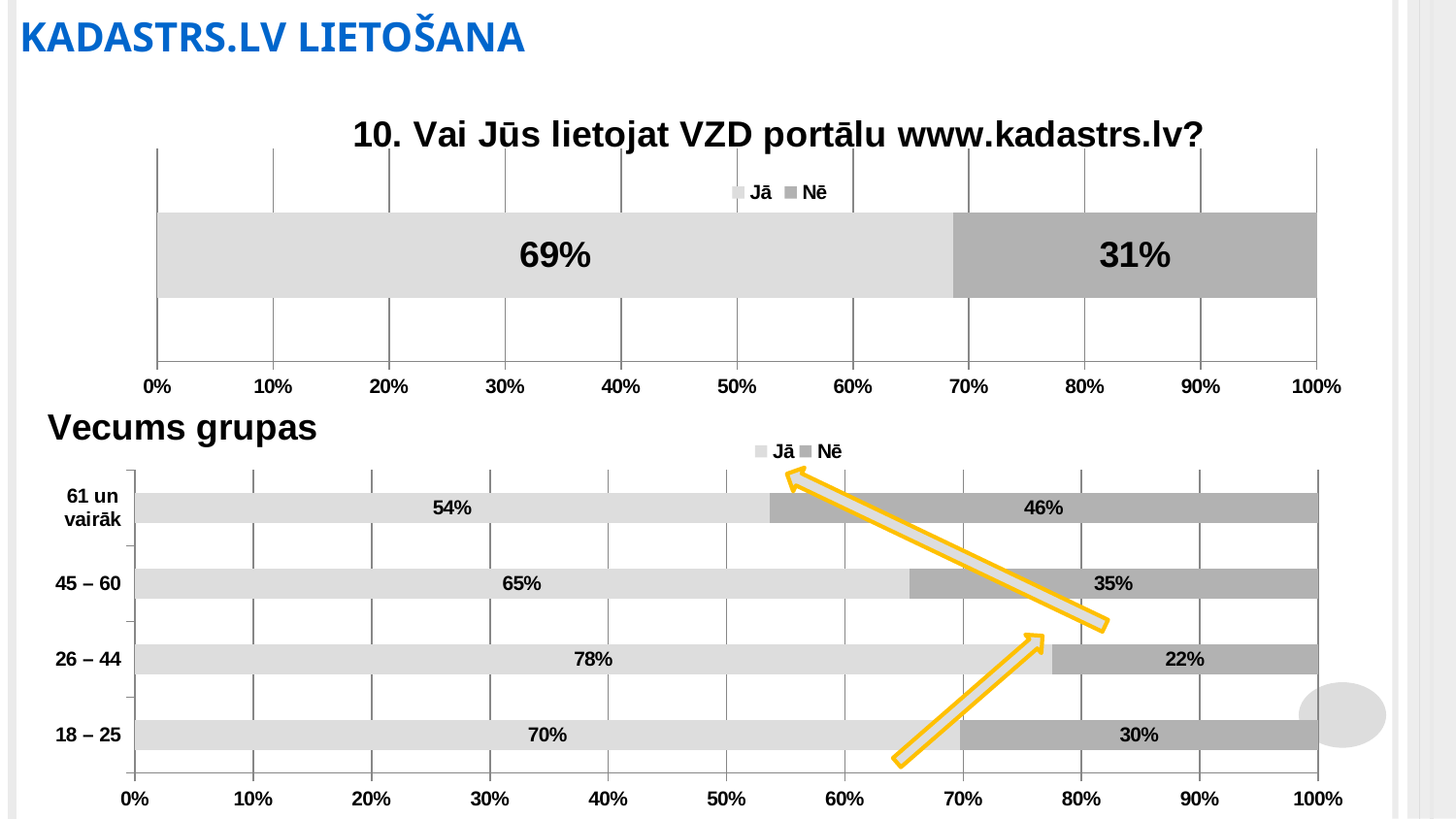
In the 'Vecums grupas' chart, what is the Jā value for the 26 – 44 age group? 78% In the top chart '10. Vai Jūs lietojat VZD portālu www.kadastrs.lv?', what is the difference between the Jā and Nē values? 38% In the 'Vecums grupas' chart, which is larger: the Nē value for 45 – 60 or the Nē value for 18 – 25? 45 – 60 In the top chart '10. Vai Jūs lietojat VZD portālu www.kadastrs.lv?', what is the value for Nē? 31% What kind of chart is the 'Vecums grupas' chart? Stacked bar chart How many age groups are shown in the 'Vecums grupas' chart? 4 In the 'Vecums grupas' chart, what is the Nē value for the 61 un vairāk age group? 46% In the 'Vecums grupas' chart, what is the difference between the Jā values for 18 – 25 and 45 – 60? 5% In the top chart '10. Vai Jūs lietojat VZD portālu www.kadastrs.lv?', what is the value for Jā? 69% In the 'Vecums grupas' chart, which age group has the lowest Jā value? 61 un vairāk In the 'Vecums grupas' chart, which age group has the highest Jā value? 26 – 44 How many series does the legend of the 'Vecums grupas' chart list? 2